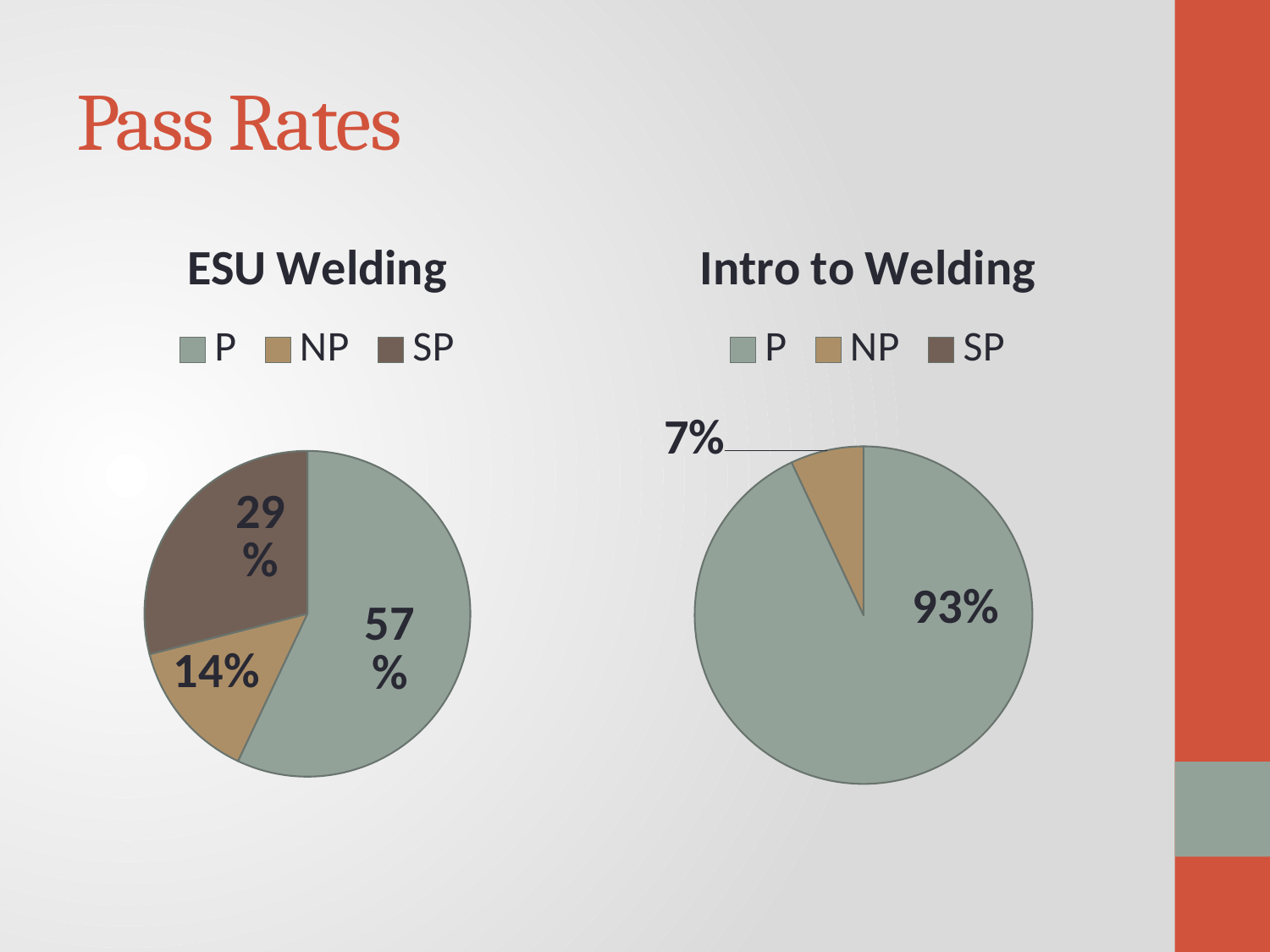
In the Intro to Welding chart, what share of the pie is P? 93% In the Intro to Welding chart, what is the difference between the P and NP shares? 86% In the ESU Welding chart, what is the difference between the P and SP shares? 28% In the ESU Welding chart, which category has the smallest slice? NP In the ESU Welding chart, which category has the largest slice? P In the ESU Welding chart, which is larger, SP or NP? SP What type of chart is the Intro to Welding chart? Pie chart In the Intro to Welding chart, what share of the pie is NP? 7% In the ESU Welding chart, what share of the pie is P? 57% How many entries does the legend of the ESU Welding chart list? 3